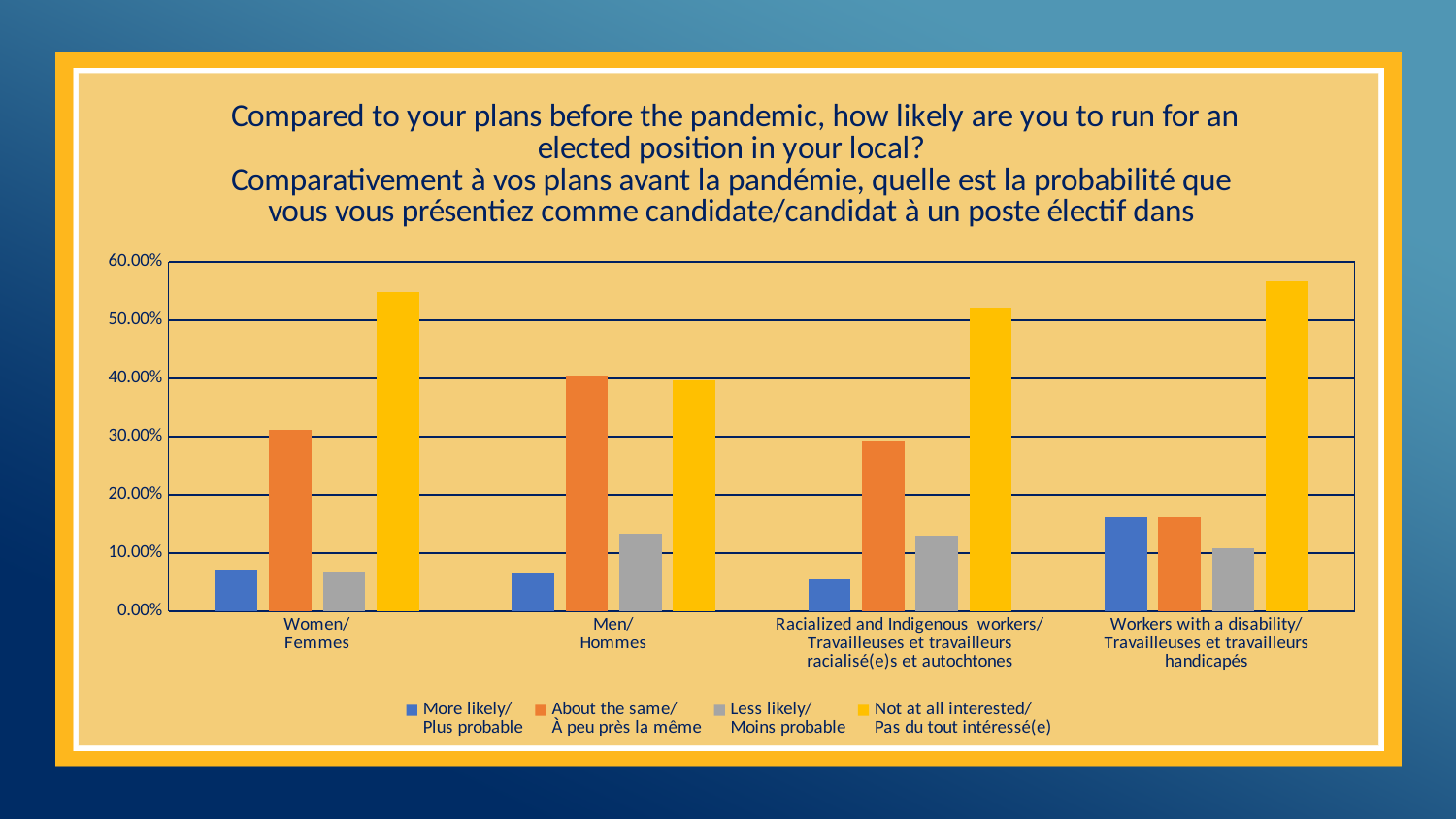
Which category has the lowest 'Not at all interested' bar? Men Which category has the highest 'More likely' bar? Workers with a disability What kind of chart is shown on the slide? bar chart How many series does the legend list? 4 Is the value for 'Not at all interested' among Racialized and Indigenous workers greater or less than 50.00%? greater What colour represents the 'Not at all interested' series in the legend? yellow Which is larger: the 'Not at all interested' value for Women or for Men? Women Is the value for 'More likely' among Workers with a disability greater or less than 10.00%? greater Which is larger: the 'About the same' value for Men or for Women? Men Is the value for 'Not at all interested' among Women greater or less than 50.00%? greater How many categories are shown along the x axis? 4